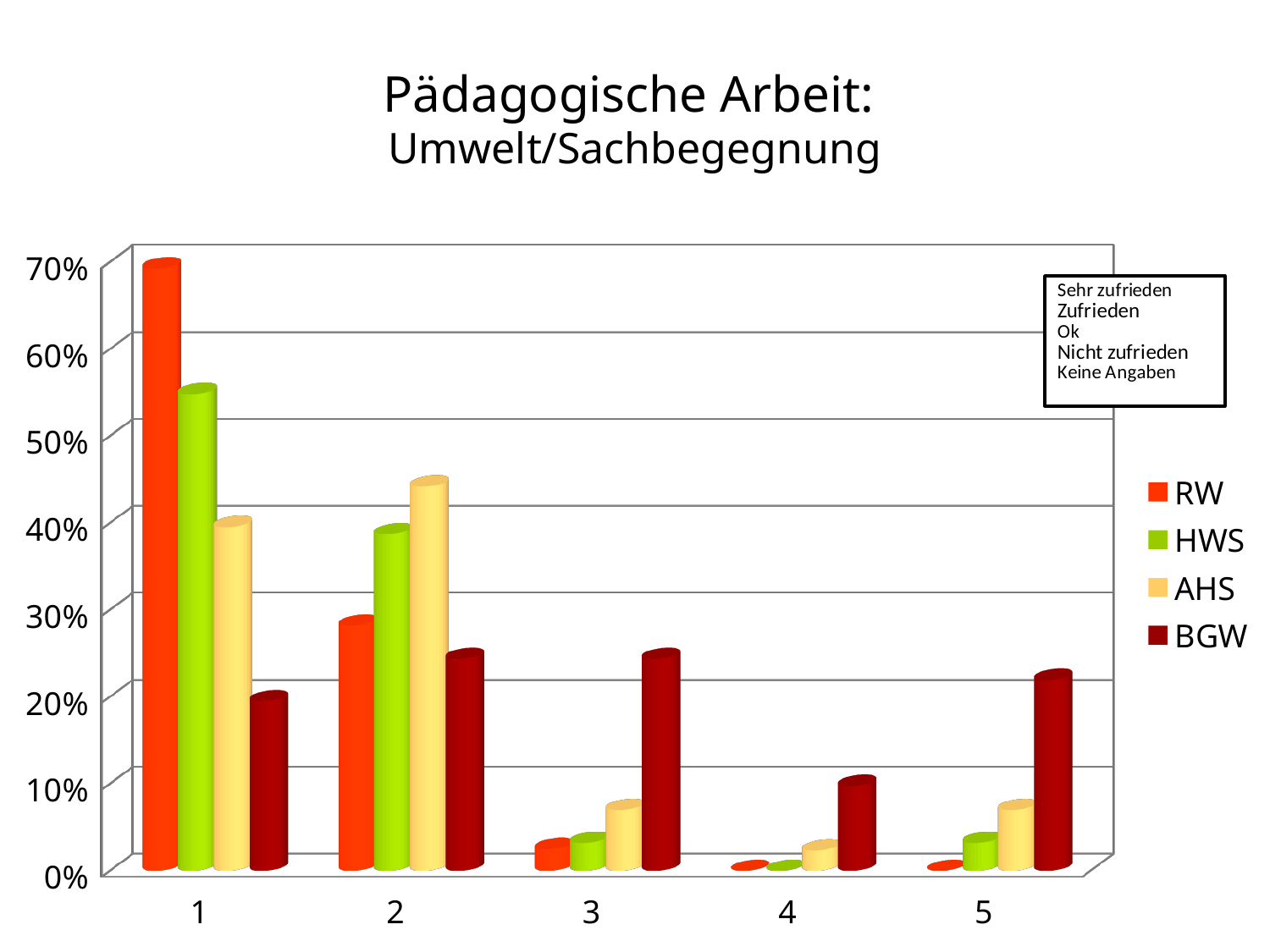
What kind of chart is shown on the slide? bar chart Do the values for RW rise or fall from category 1 to category 5? fall How many categories are shown on the x axis? 5 Which series has the highest value in category 1? RW Which is larger in category 2: the value for HWS or the value for AHS? AHS Is the value for BGW in category 1 greater or less than 30%? less How many series does the legend list? 4 Is the value for AHS in category 2 greater or less than 40%? greater Which series has the highest value in category 3? BGW Is the value for RW in category 1 greater or less than 60%? greater Which series has the highest value in category 2? AHS